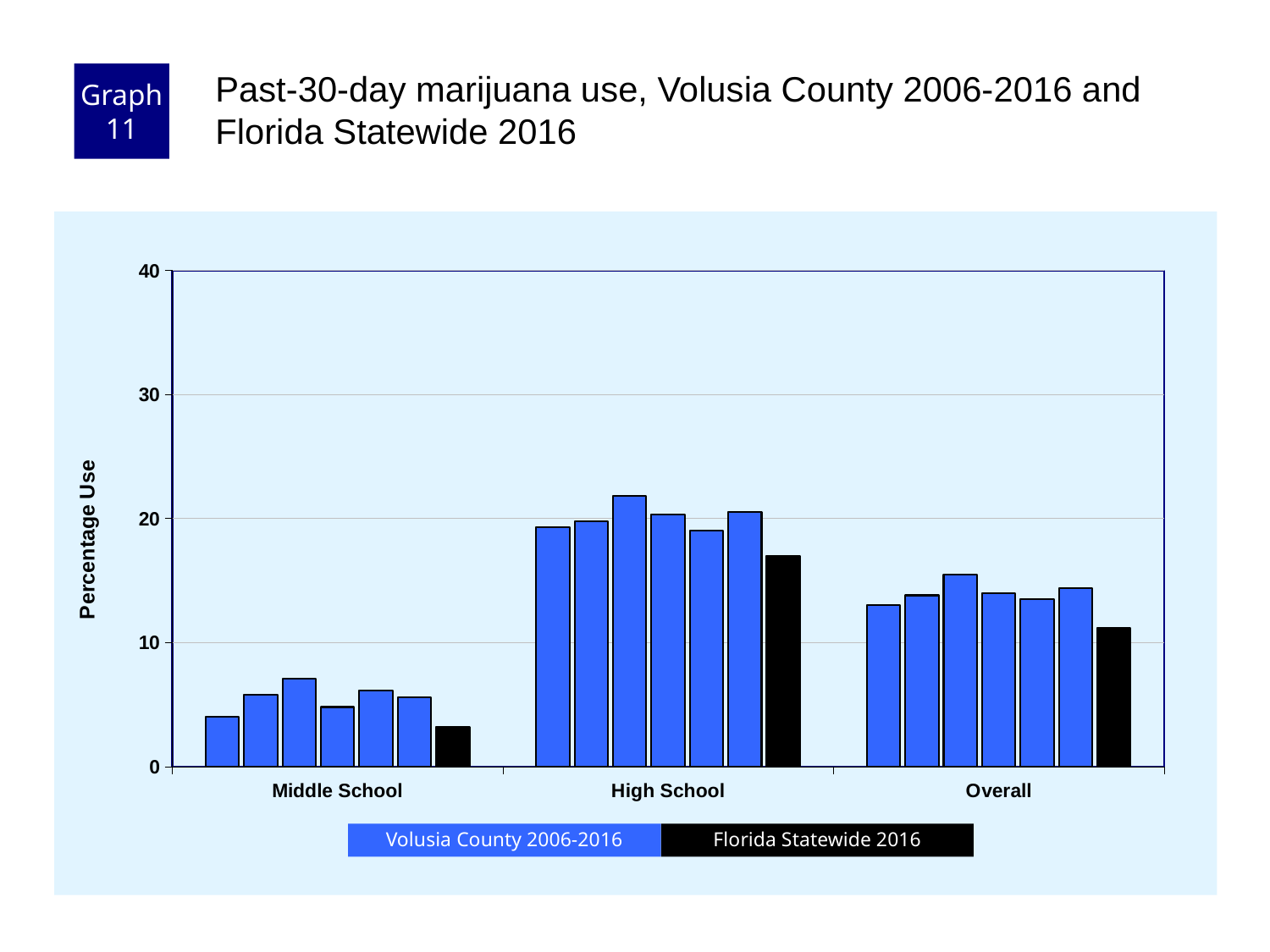
How many series does the legend list? 2 What kind of chart is shown on the slide? bar chart How many categories are shown on the x axis? 3 Is the Florida Statewide 2016 value for Middle School greater or less than 10? less Is the Florida Statewide 2016 value for High School greater or less than 10? greater Which category has the highest percentage use? High School Are all the Volusia County 2006-2016 bars for High School greater or less than 30? less Which category has the lowest percentage use? Middle School What is the label on the y axis? Percentage Use For High School, which is larger: the Florida Statewide 2016 bar or the tallest Volusia County 2006-2016 bar? the tallest Volusia County 2006-2016 bar What colour are the Florida Statewide 2016 bars? black